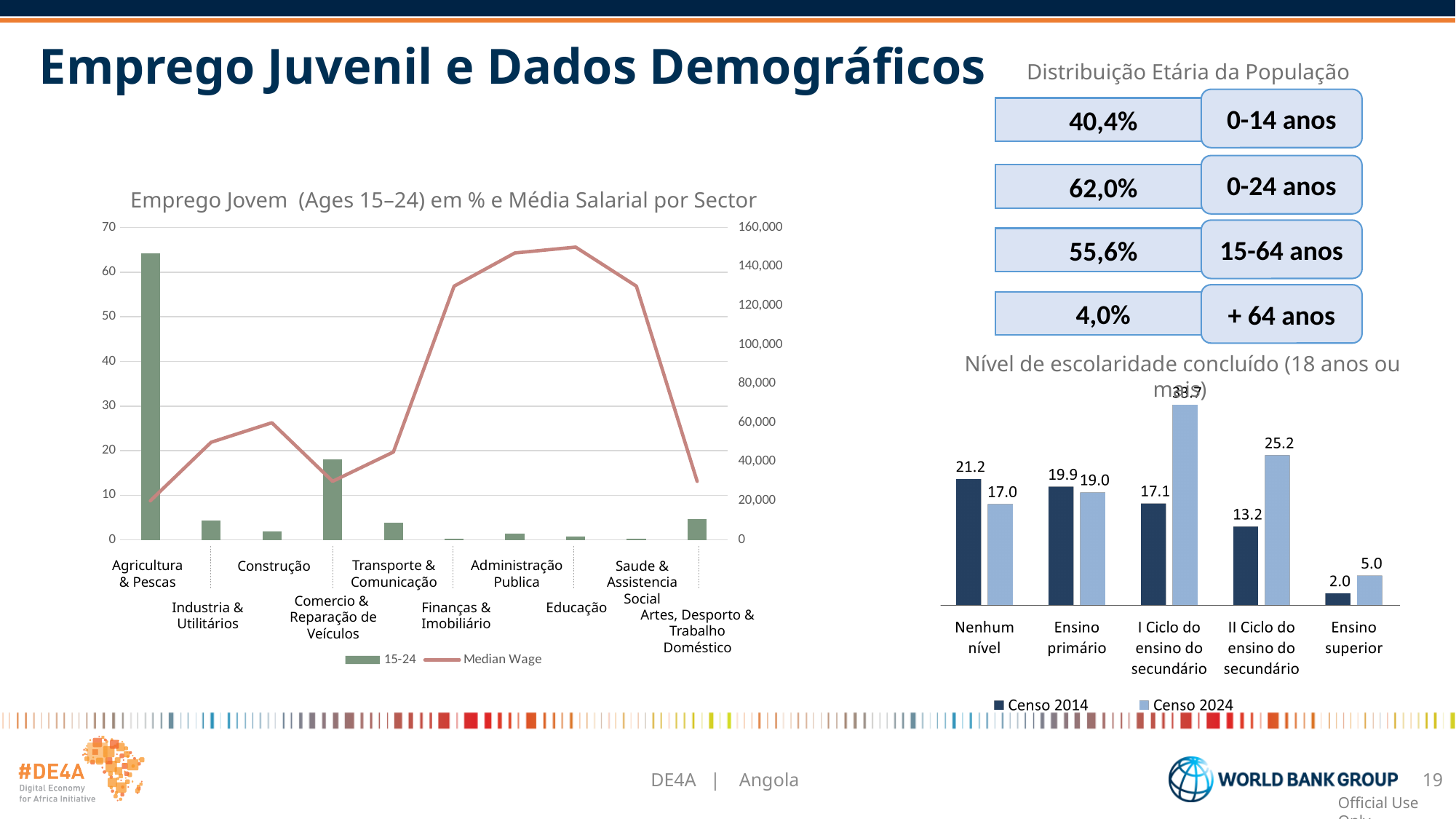
In the chart 'Nível de escolaridade concluído (18 anos ou mais)', how many series does the legend list? 2 In the chart 'Nível de escolaridade concluído (18 anos ou mais)', what is the Censo 2014 value for 'Nenhum nível'? 21.2 In the chart 'Nível de escolaridade concluído (18 anos ou mais)', what is the Censo 2024 value for 'II Ciclo do ensino do secundário'? 25.2 In the chart 'Nível de escolaridade concluído (18 anos ou mais)', how many education-level categories are shown? 5 In the chart 'Emprego Jovem (Ages 15–24) em % e Média Salarial por Sector', is the 15-24 value for 'Agricultura & Pescas' greater or less than 60? greater In the chart 'Emprego Jovem (Ages 15–24) em % e Média Salarial por Sector', how many sectors are shown on the x axis? 10 In the chart 'Nível de escolaridade concluído (18 anos ou mais)', what is the Censo 2024 value for 'Ensino superior'? 5.0 In the chart 'Emprego Jovem (Ages 15–24) em % e Média Salarial por Sector', which sector has the highest Median Wage? Educação In the chart 'Nível de escolaridade concluído (18 anos ou mais)', which is larger for 'Ensino primário': the Censo 2014 value or the Censo 2024 value? Censo 2014 In the chart 'Nível de escolaridade concluído (18 anos ou mais)', which category has the lowest Censo 2014 value? Ensino superior In the chart 'Emprego Jovem (Ages 15–24) em % e Média Salarial por Sector', which sector has the highest 15-24 bar? Agricultura & Pescas In the chart 'Nível de escolaridade concluído (18 anos ou mais)', what is the difference between the Censo 2024 and Censo 2014 values for 'II Ciclo do ensino do secundário'? 12.0